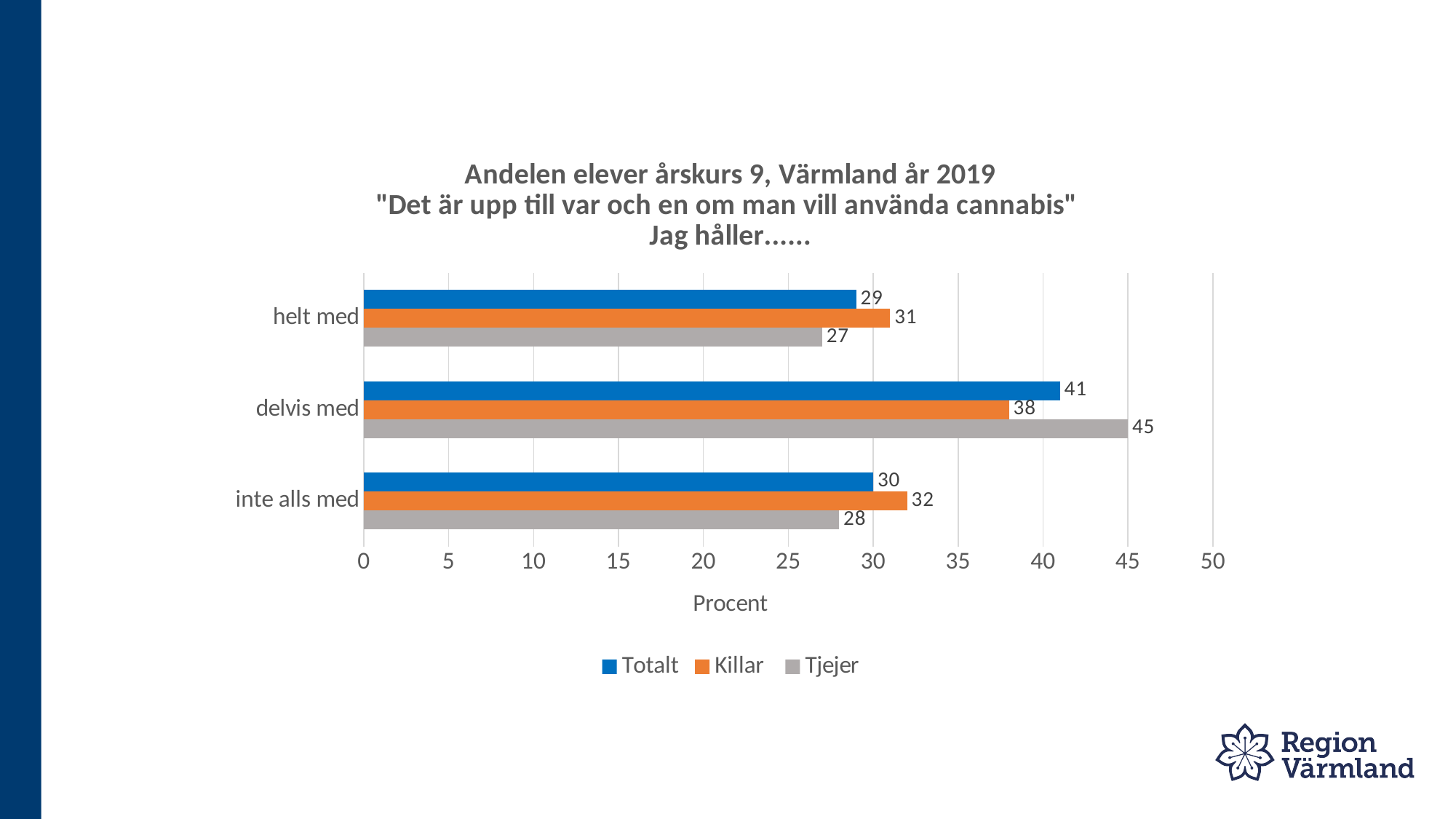
Which category has the lowest value for Tjejer? helt med Which is larger: the Killar value for 'helt med' or the Killar value for 'inte alls med'? inte alls med Which category has the highest value for Totalt? delvis med Is the value for Totalt in 'delvis med' greater or less than 40? greater What kind of chart is shown on the slide? bar chart How many categories are shown on the y axis? 3 What is the label of the x axis? Procent What is the value for Killar in the 'helt med' category? 31 What is the value for Tjejer in the 'delvis med' category? 45 What is the value for Totalt in the 'inte alls med' category? 30 How many series does the legend list? 3 What is the difference between the Tjejer and Killar values in the 'delvis med' category? 7